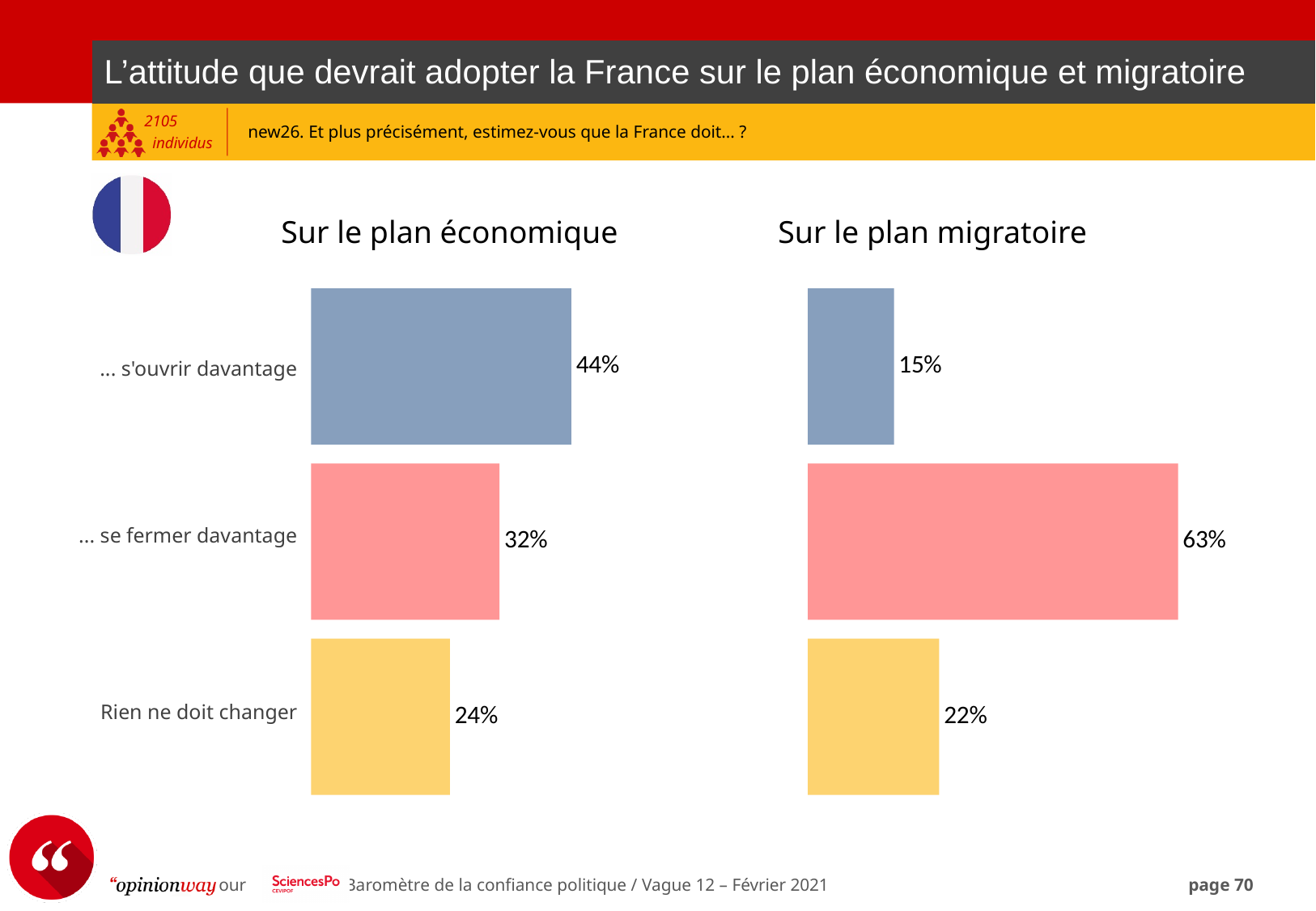
In the 'Sur le plan économique' chart, what is the difference between '... s'ouvrir davantage' and '... se fermer davantage'? 12% In the 'Sur le plan migratoire' chart, what is the value for '... s'ouvrir davantage'? 15% In the 'Sur le plan migratoire' chart, what is the value for '... se fermer davantage'? 63% What kind of chart is the 'Sur le plan économique' chart? Bar chart In the 'Sur le plan migratoire' chart, what colour is the bar for '... se fermer davantage'? Pink/red In the 'Sur le plan migratoire' chart, what is the difference between '... se fermer davantage' and 'Rien ne doit changer'? 41% How many categories does the 'Sur le plan migratoire' chart show? 3 In the 'Sur le plan migratoire' chart, which category has the lowest value? ... s'ouvrir davantage Which is larger: 'Rien ne doit changer' in the 'Sur le plan économique' chart or 'Rien ne doit changer' in the 'Sur le plan migratoire' chart? Sur le plan économique In the 'Sur le plan économique' chart, which category has the highest value? ... s'ouvrir davantage In the 'Sur le plan économique' chart, what is the value for '... s'ouvrir davantage'? 44% In the 'Sur le plan économique' chart, what is the value for 'Rien ne doit changer'? 24%